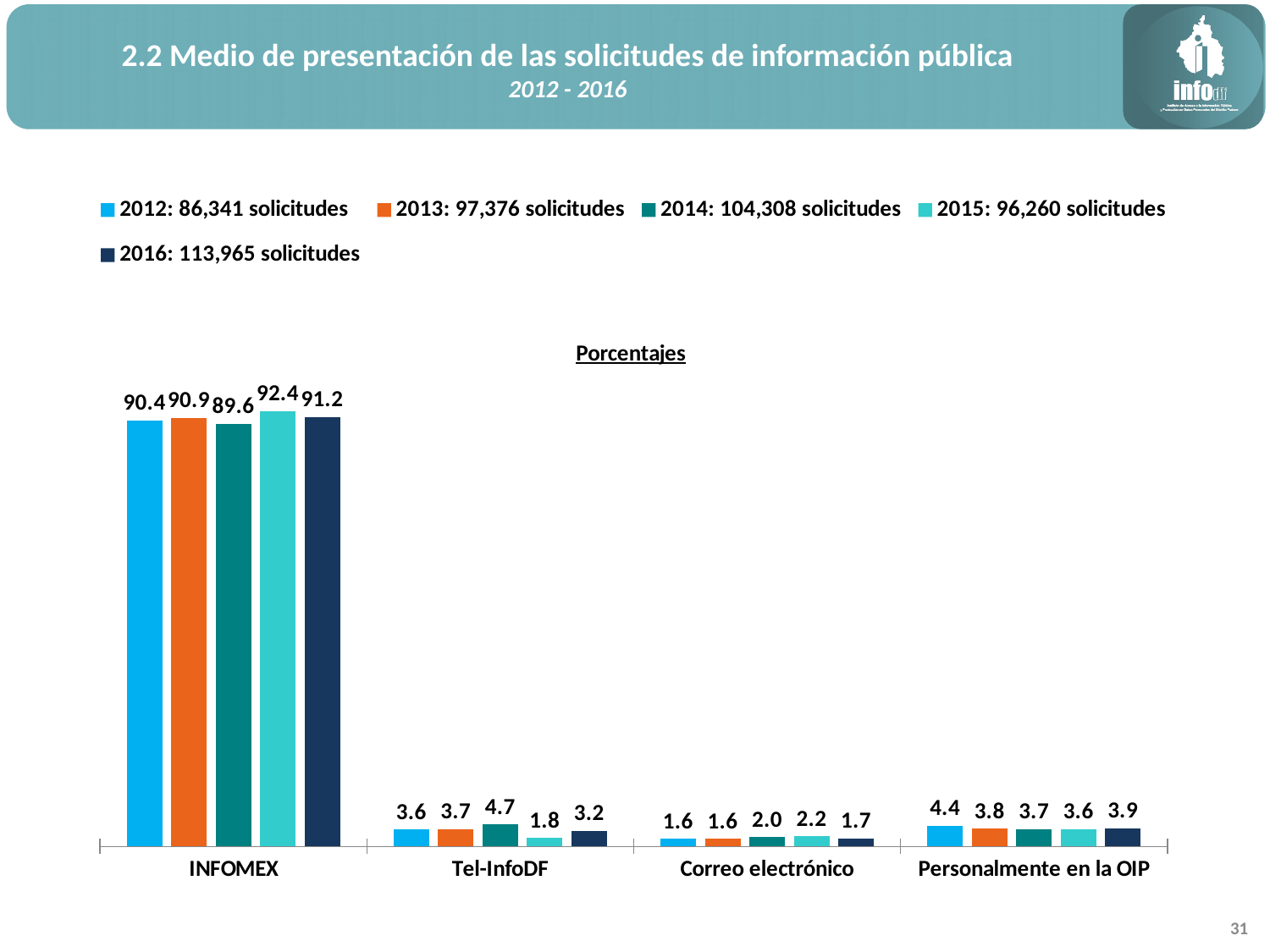
How many categories are shown on the x axis? 4 What is the value for INFOMEX in the 2015 series? 92.4 What is the value for Tel-InfoDF in the 2014 series? 4.7 What is the difference between the 2015 and 2014 values for INFOMEX? 2.8 Which category has the highest value in the 2016 series? INFOMEX What is the value for Personalmente en la OIP in the 2012 series? 4.4 Which is larger for Tel-InfoDF: the 2012 value or the 2015 value? 2012 What kind of chart is shown on the slide? bar chart What is the value for Correo electrónico in the 2016 series? 1.7 Which category has the lowest value in the 2013 series? Correo electrónico According to the legend, how many solicitudes were there in 2016? 113,965 How many series does the legend list? 5